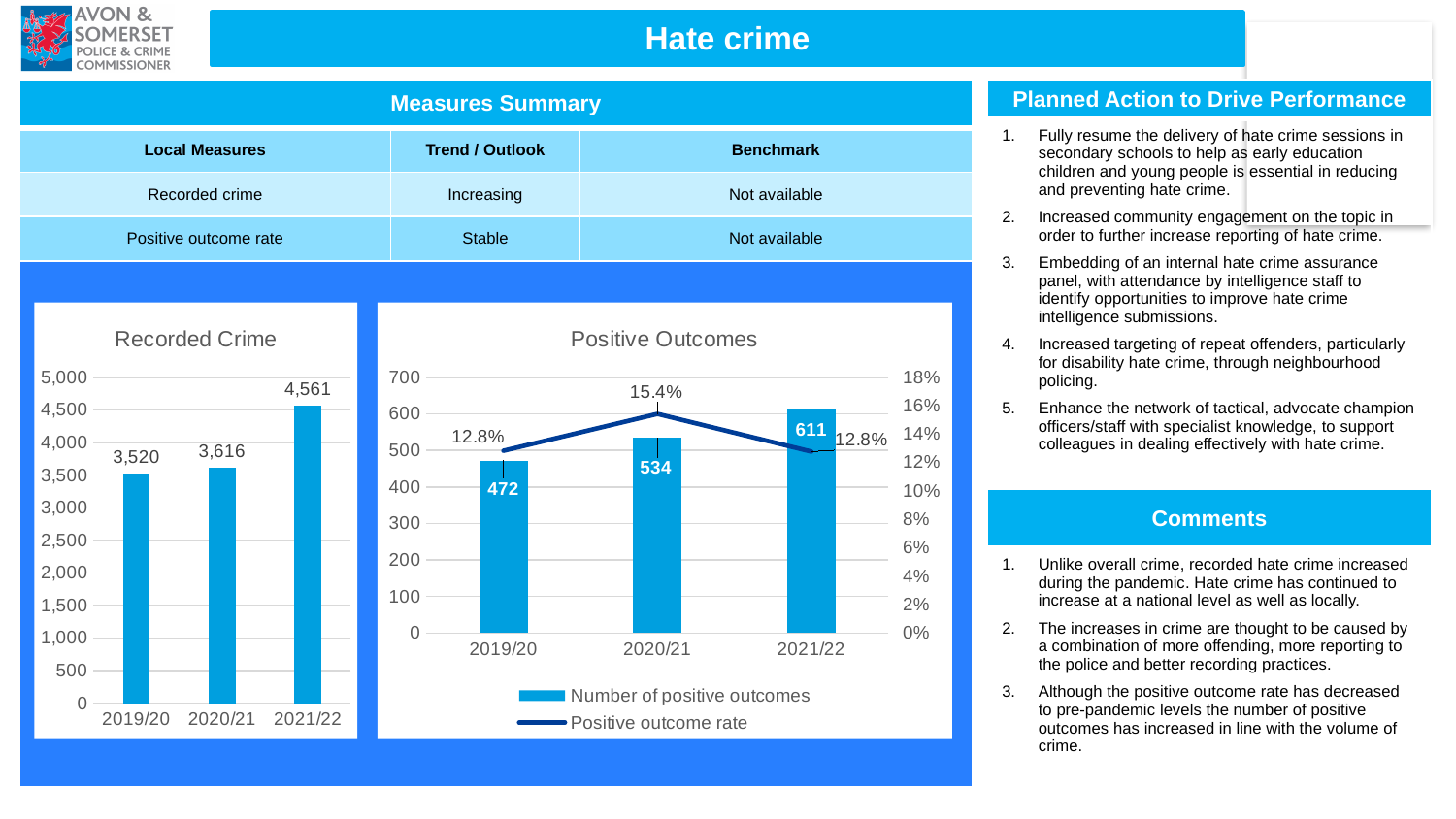
In the Positive Outcomes chart, what is the difference in the number of positive outcomes between 2021/22 and 2019/20? 139 In the Recorded Crime chart, which year has the highest recorded crime? 2021/22 How many series does the legend of the Positive Outcomes chart list? 2 In the Recorded Crime chart, do the values rise or fall from 2019/20 to 2021/22? rise In the Positive Outcomes chart, what is the number of positive outcomes for 2020/21? 534 In the Recorded Crime chart, what is the difference between the 2021/22 and 2020/21 values? 945 What kind of chart is the Recorded Crime chart? bar chart In the Positive Outcomes chart, what is the positive outcome rate for 2020/21? 15.4% In the Recorded Crime chart, what is the value for 2019/20? 3,520 In the Positive Outcomes chart, which year has the highest number of positive outcomes? 2021/22 In the Recorded Crime chart, which year has the lowest recorded crime? 2019/20 In the Recorded Crime chart, what is the value for 2021/22? 4,561